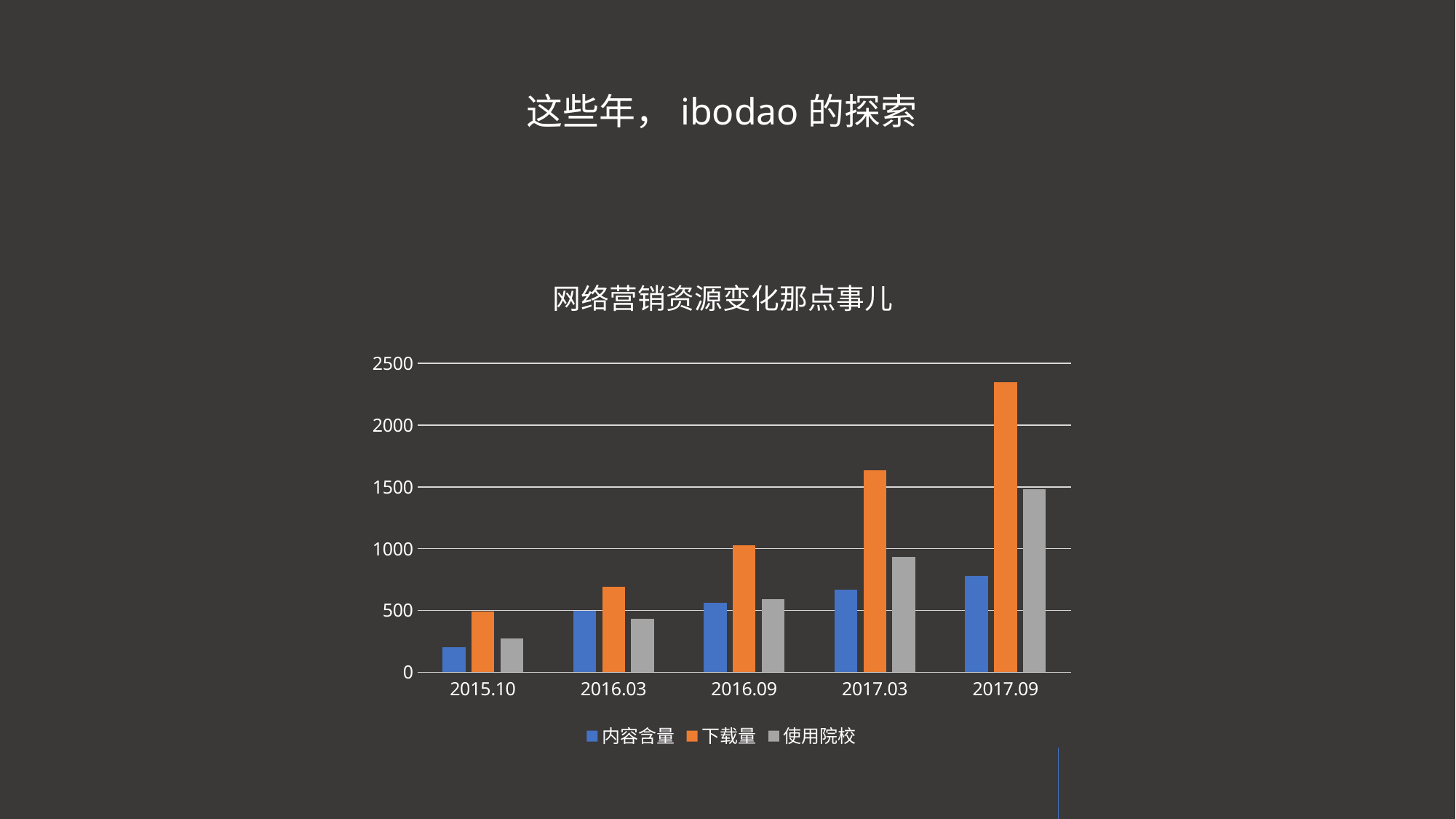
What kind of chart is shown on the slide? bar chart Is the 下载量 value for 2017.09 greater or less than 2000? greater In which category is the 内容含量 value lowest? 2015.10 How many categories are shown on the x axis? 5 Is the 下载量 value for 2017.03 greater or less than 1500? greater How many series does the legend list? 3 Which series is shown in orange? 下载量 Do the 下载量 values rise or fall from 2015.10 to 2017.09? rise For 2017.09, which is larger: 下载量 or 使用院校? 下载量 What is the title of the chart? 网络营销资源变化那点事儿 Is the 内容含量 value for 2015.10 greater or less than 500? less In which category is the 下载量 value highest? 2017.09